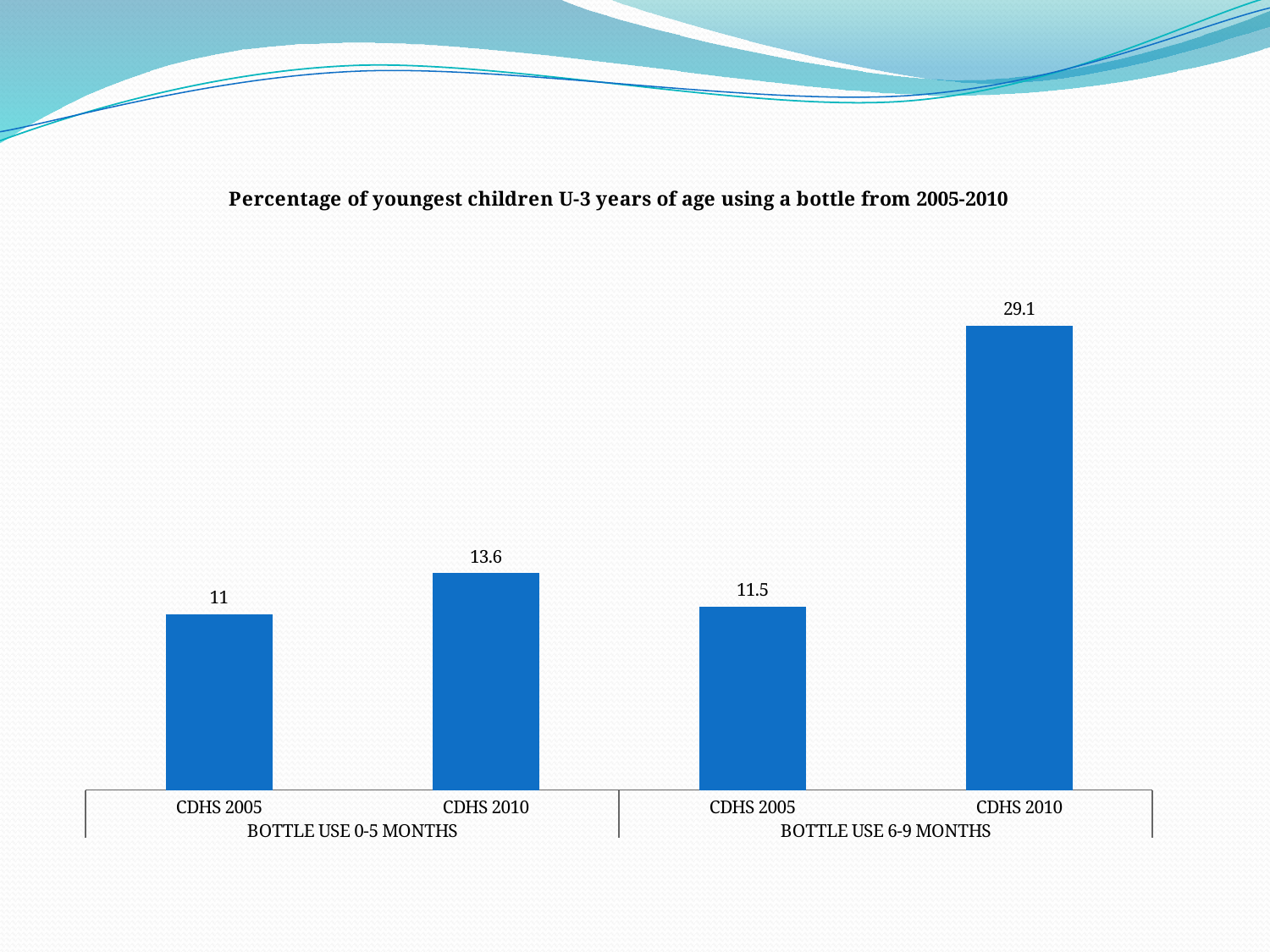
What kind of chart is shown on the slide? Bar chart Which bar has the highest value? CDHS 2010, Bottle Use 6-9 Months What is the value for CDHS 2010 in the Bottle Use 0-5 Months group? 13.6 How many bars are plotted on the chart? 4 What is the difference between CDHS 2010 and CDHS 2005 in the Bottle Use 6-9 Months group? 17.6 What is the value for CDHS 2005 in the Bottle Use 0-5 Months group? 11 What is the difference between CDHS 2010 and CDHS 2005 in the Bottle Use 0-5 Months group? 2.6 What is the title of the chart? Percentage of youngest children U-3 years of age using a bottle from 2005-2010 Which is larger: CDHS 2010 for Bottle Use 0-5 Months or CDHS 2005 for Bottle Use 6-9 Months? CDHS 2010 for Bottle Use 0-5 Months What is the value for CDHS 2010 in the Bottle Use 6-9 Months group? 29.1 What is the value for CDHS 2005 in the Bottle Use 6-9 Months group? 11.5 Which bar has the lowest value? CDHS 2005, Bottle Use 0-5 Months